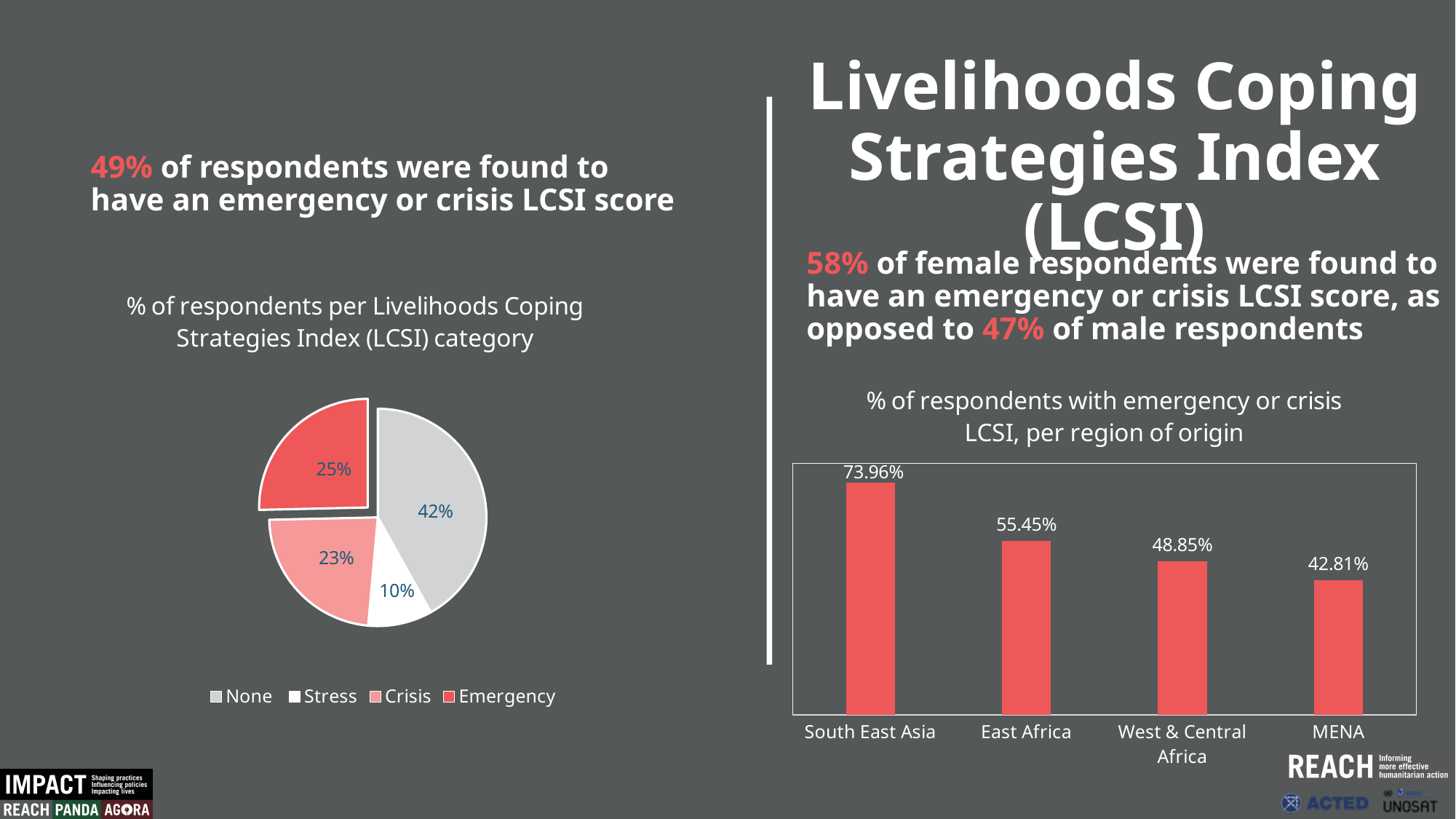
In the bar chart on the right, which region has the lowest value? MENA In the bar chart on the right, how many regions are shown? 4 What type of chart is used to show '% of respondents with emergency or crisis LCSI, per region of origin'? Bar chart In the pie chart on the left, what is the difference between the Crisis and Stress shares? 13% In the pie chart on the left, how many categories does the legend list? 4 In the bar chart '% of respondents with emergency or crisis LCSI, per region of origin', what is the value for East Africa? 55.45% In the bar chart on the right, what is the difference between the values for South East Asia and MENA? 31.15% In the pie chart on the left, which LCSI category has the largest share? None In the pie chart '% of respondents per Livelihoods Coping Strategies Index (LCSI) category', what share of respondents fall in the None category? 42% In the pie chart on the left, what percentage of respondents are in the Emergency category? 25% In the bar chart on the right, which region has the highest percentage of respondents with emergency or crisis LCSI? South East Asia In the pie chart on the left, which LCSI category has the smallest share? Stress